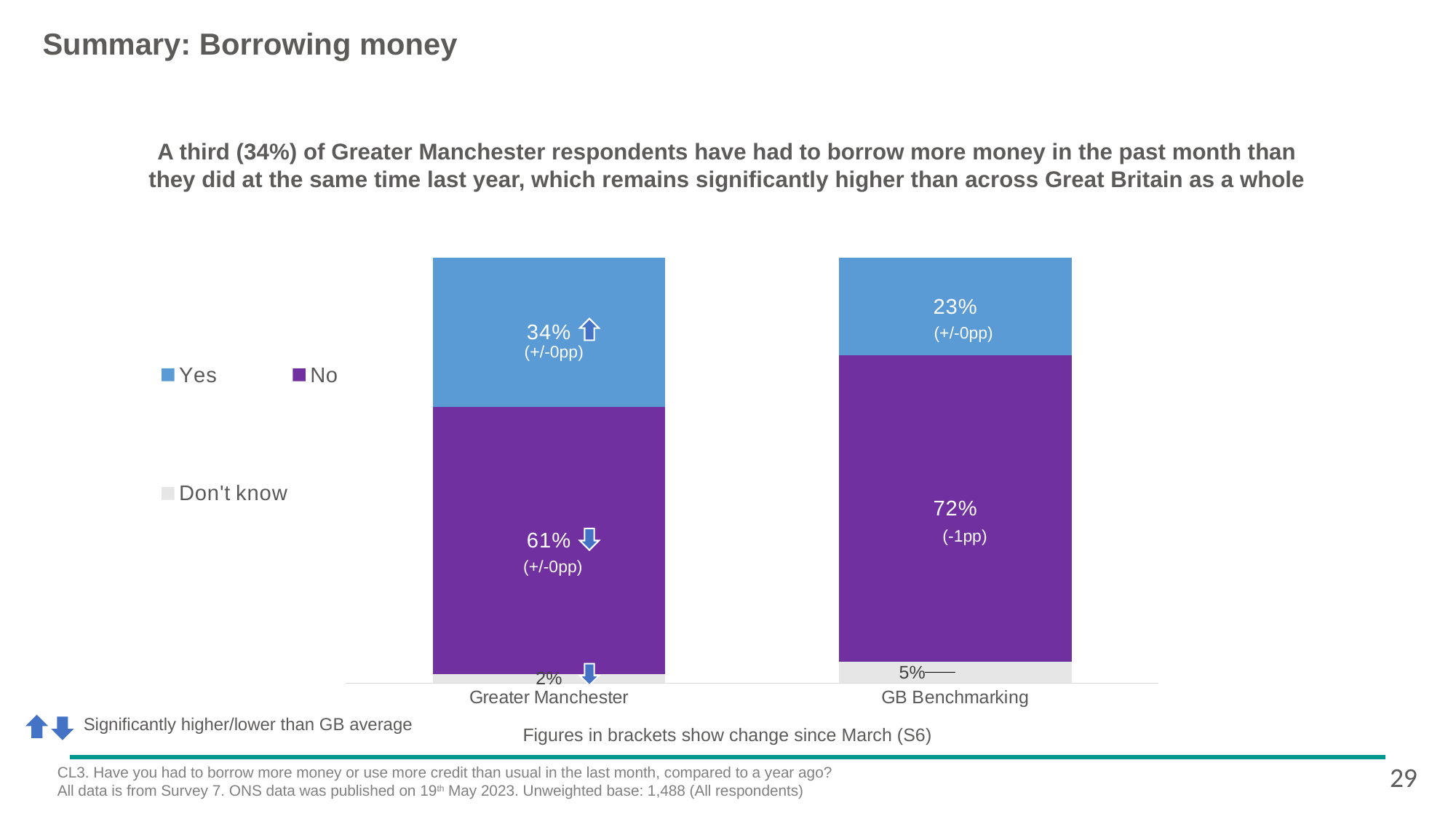
What is the Don't know value for GB Benchmarking? 5% Which category has the higher Yes value? Greater Manchester What kind of chart is shown? Stacked bar chart Which has the larger No value, Greater Manchester or GB Benchmarking? GB Benchmarking How many categories are shown on the x axis? 2 What percentage of Greater Manchester respondents answered Yes? 34% How many series does the legend list? 3 What percentage of GB Benchmarking respondents answered No? 72% What is the difference between the Yes values for Greater Manchester and GB Benchmarking? 11 percentage points Which legend entry is shown in purple? No What is the change since March shown in brackets for the GB Benchmarking No value? -1pp What is the Don't know value for Greater Manchester? 2%